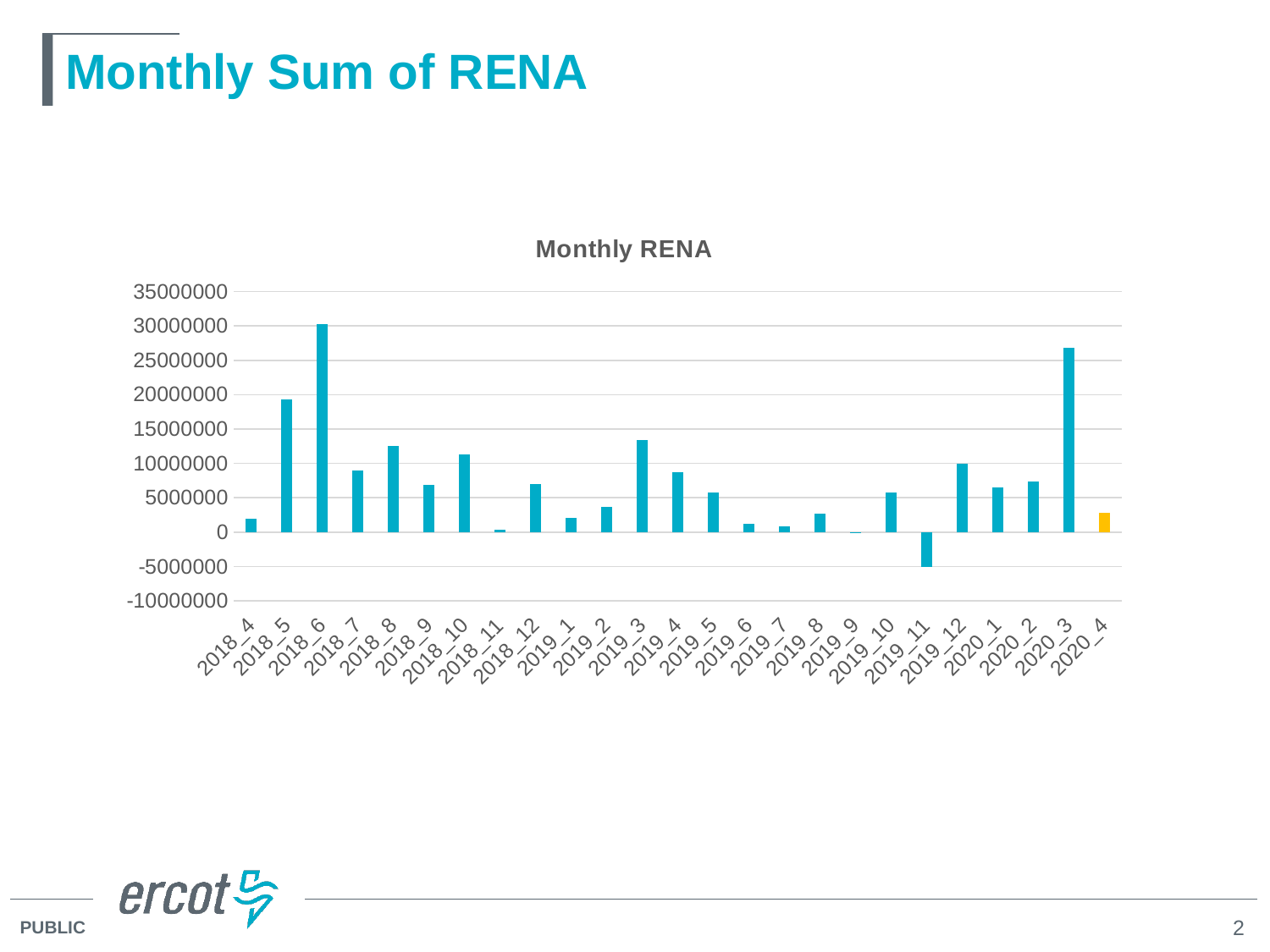
Which is larger, the value for 2018_6 or the value for 2020_3? 2018_6 What is the title of the chart? Monthly RENA Is the value for 2019_11 greater or less than 0? less What type of chart is shown on the slide? bar chart Is the value for 2019_3 greater or less than 10000000? greater How many months (categories) are plotted on the x axis? 25 Is the value for 2020_4 greater or less than 5000000? less Which bar is shown in a different colour (yellow) from the rest? 2020_4 Which month has the highest Monthly RENA value? 2018_6 Which month has the lowest Monthly RENA value? 2019_11